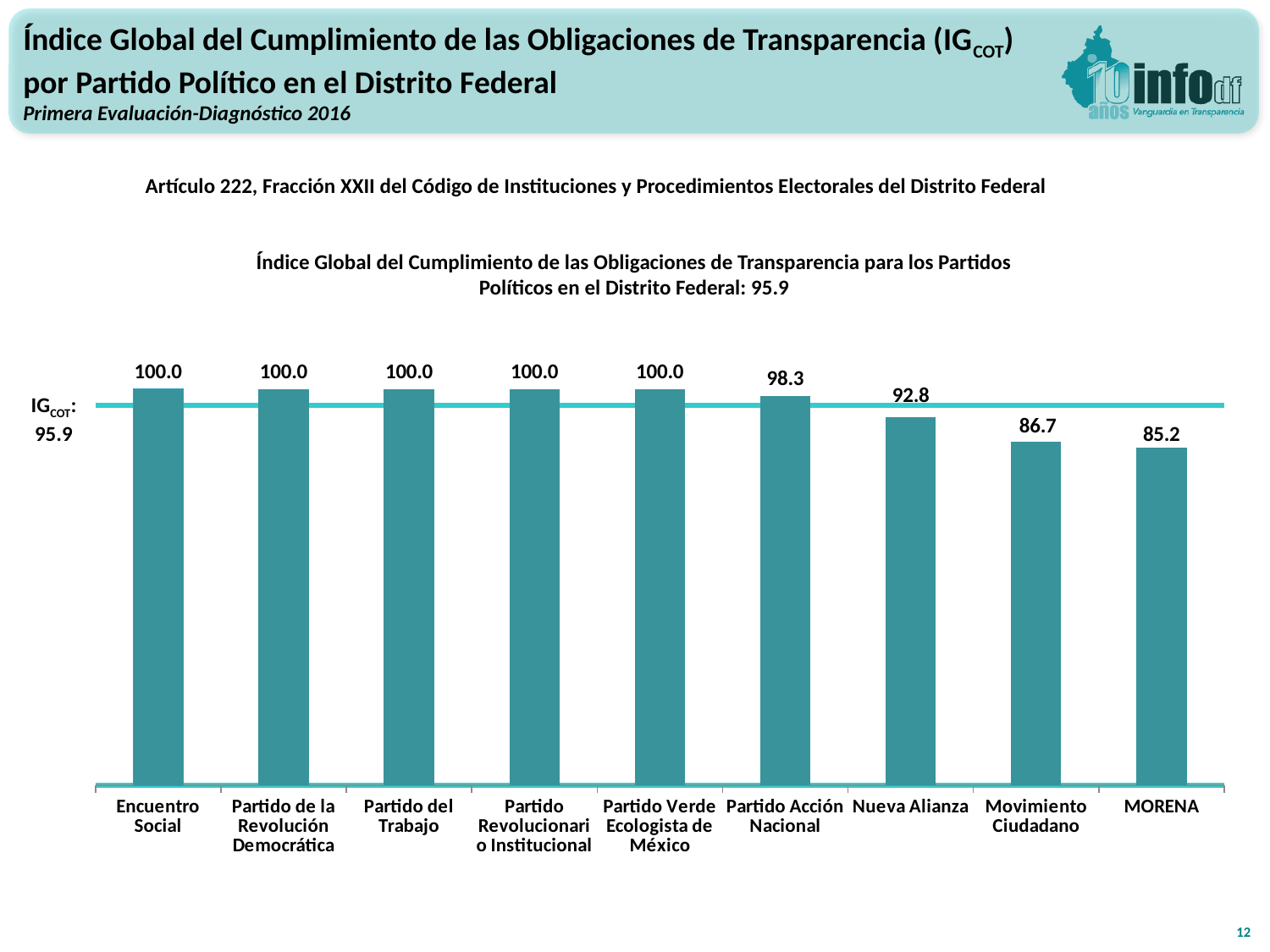
Do the values rise or fall from left to right across the chart? fall What is the overall IGCOT value marked by the horizontal line on the chart? 95.9 Which party has the lowest value? MORENA Which is larger, the value for Nueva Alianza or the value for Movimiento Ciudadano? Nueva Alianza What is the value for MORENA? 85.2 What is the difference between the values for Nueva Alianza and Movimiento Ciudadano? 6.1 What is the value for Movimiento Ciudadano? 86.7 How many parties are shown in the chart? 9 What kind of chart is shown on the slide? bar chart What is the value for Partido Acción Nacional? 98.3 What is the difference between the values for Partido Acción Nacional and MORENA? 13.1 What is the value for Nueva Alianza? 92.8